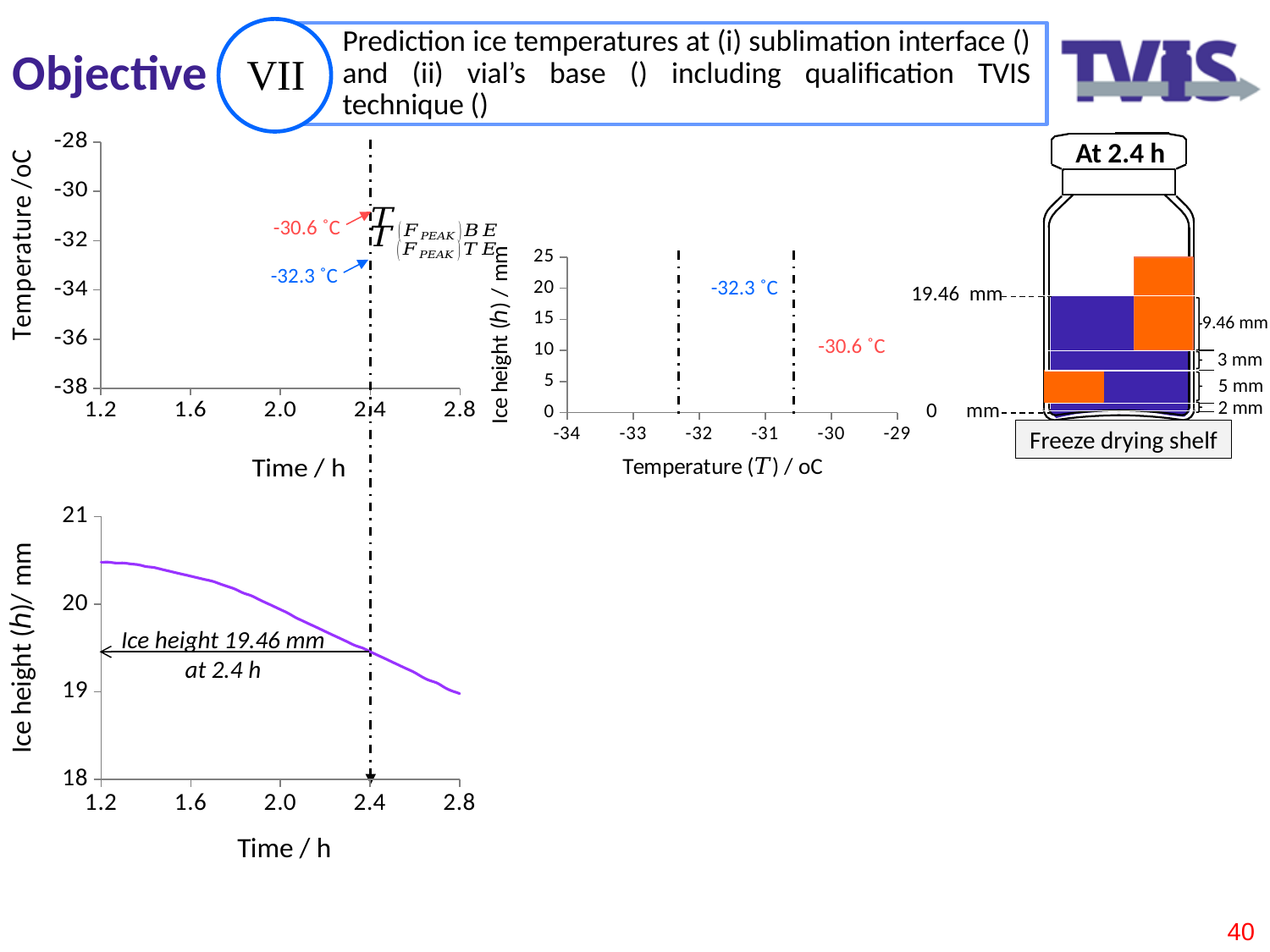
In the top-left temperature chart, which of the two annotated temperatures at 2.4 h is higher, -30.6 °C or -32.3 °C? -30.6 °C How many tick labels are shown on the x axis of the bottom-left chart? 5 In the top-left temperature chart, what is the difference between the two annotated temperatures -30.6 °C and -32.3 °C? 1.7 °C In the bottom-left chart, is the ice height at 1.2 h greater or less than 20 mm? greater In the bottom-left chart, what is the ice height at 2.4 h? 19.46 mm What is the x-axis label of the middle chart of ice height against temperature? Temperature (T) / oC In the middle chart, at which two temperatures are the vertical dashed lines annotated? -32.3 °C and -30.6 °C In the top-left chart, what is the lowest value shown on the temperature axis? -38 In the bottom-left chart, does the ice height rise or fall as time increases from 1.2 h to 2.8 h? fall In the bottom-left chart, is the ice height at 1.6 h greater or less than 20 mm? greater What kind of chart is the bottom-left chart of ice height against time? line chart In the bottom-left chart, is the ice height at 2.4 h greater or less than 20 mm? less